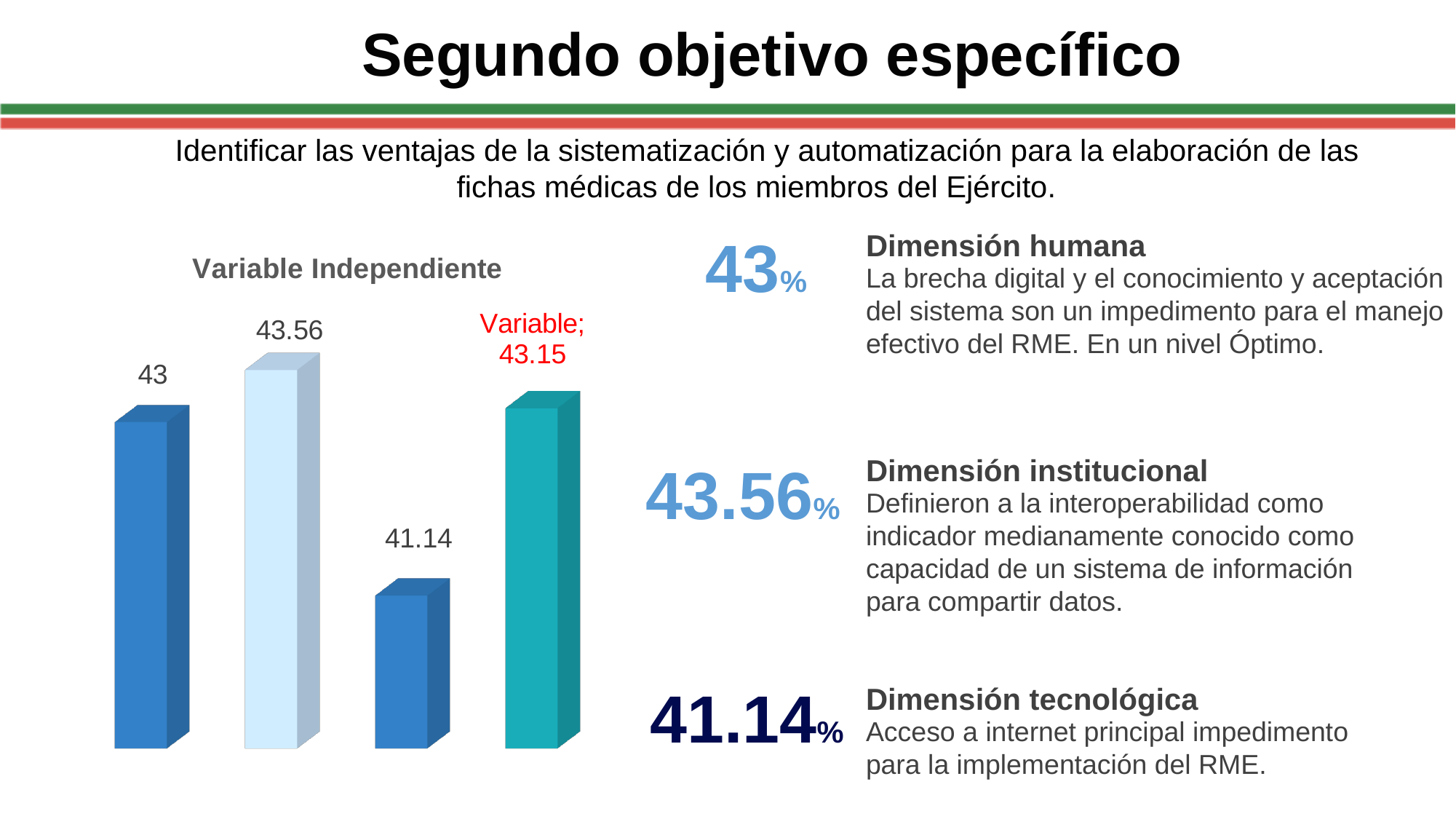
What kind of chart is shown on the slide? bar chart What is the value of the bar labelled "Variable" in the chart? 43.15 What is the title of the chart on the slide? Variable Independiente What colour is the bar labelled "Variable" in the chart? teal What is the value of the second bar in the chart? 43.56 What is the value of the third bar in the chart? 41.14 Which bar has the lowest value in the chart? the third bar (41.14) Which bar has the highest value in the chart? the second bar (43.56) How many bars does the chart show? 4 What is the value of the first (leftmost) bar in the chart? 43 What is the difference between the second bar (43.56) and the third bar (41.14)? 2.42 Which is larger, the first bar (43) or the bar labelled "Variable" (43.15)? Variable (43.15)